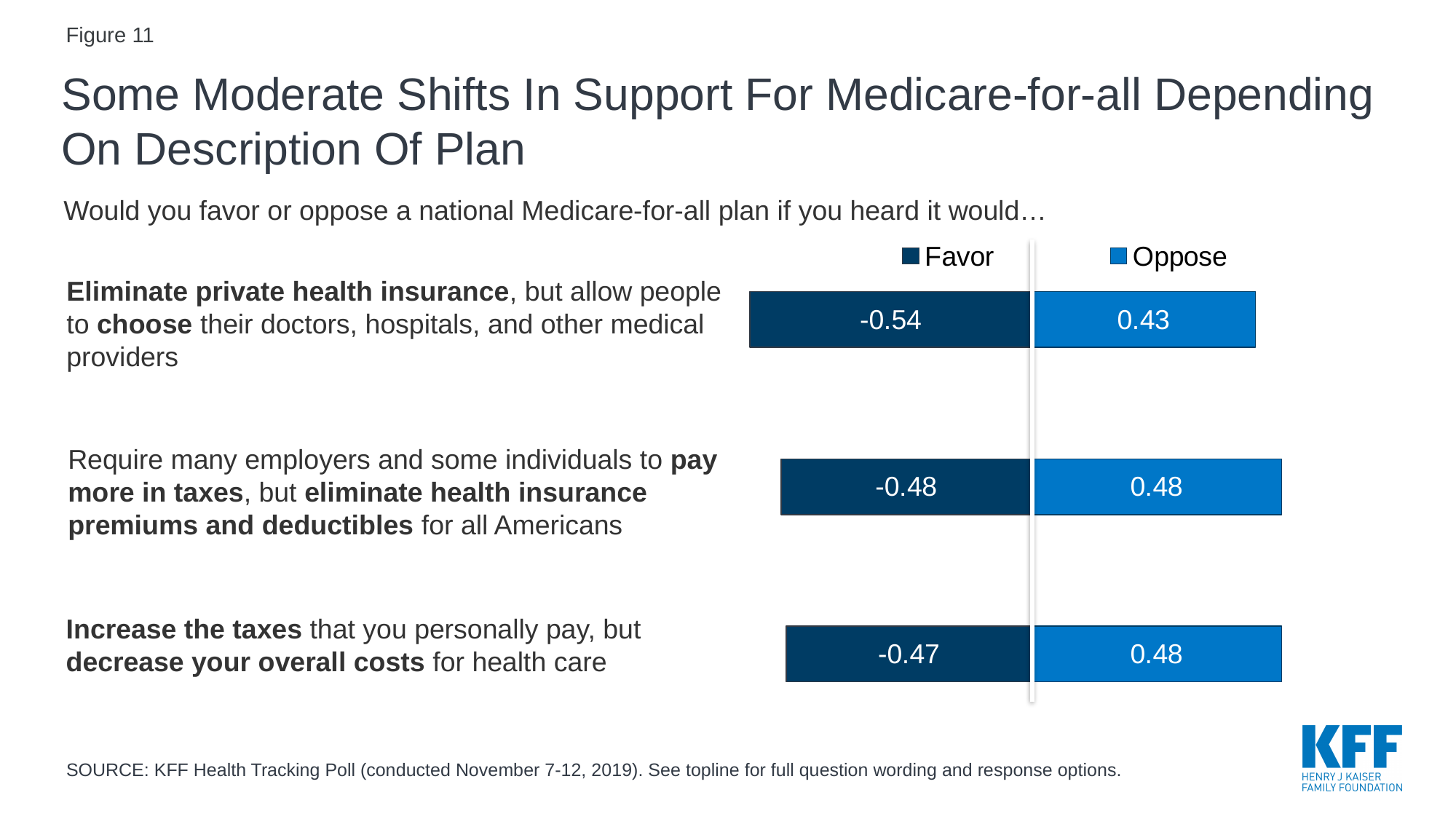
What kind of chart is shown on the slide? Bar chart How many series does the legend list? 2 What is the Oppose value for 'Increase the taxes that you personally pay, but decrease your overall costs for health care'? 0.48 What is the Favor value for the description 'Eliminate private health insurance, but allow people to choose their doctors, hospitals, and other medical providers'? -0.54 What is the Favor value for 'Require many employers and some individuals to pay more in taxes, but eliminate health insurance premiums and deductibles for all Americans'? -0.48 Which plan description has the longest Favor bar? Eliminate private health insurance, but allow people to choose their doctors, hospitals, and other medical providers What is the Favor value for 'Increase the taxes that you personally pay, but decrease your overall costs for health care'? -0.47 In absolute terms, how much larger is the Favor share than the Oppose share for the 'Eliminate private health insurance' description? 0.11 What is the Oppose value for the description 'Eliminate private health insurance, but allow people to choose their doctors, hospitals, and other medical providers'? 0.43 Which plan description has the lowest Oppose value? Eliminate private health insurance, but allow people to choose their doctors, hospitals, and other medical providers How many plan descriptions are shown in the chart? 3 For the 'Eliminate private health insurance' description, which bar is longer, Favor or Oppose? Favor